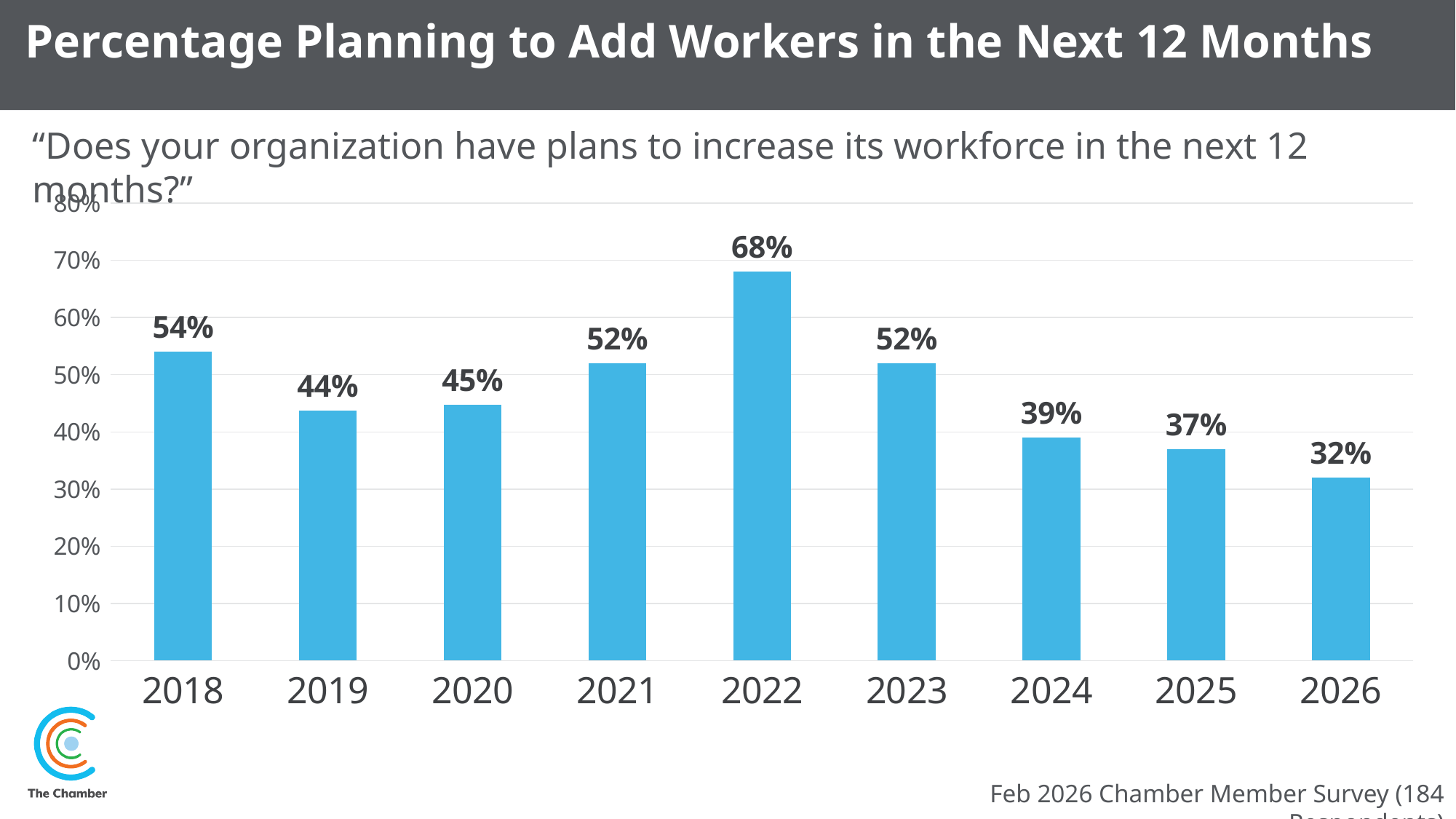
What kind of chart is shown on the slide? Bar chart What is the value shown for 2026? 32% What percentage of organizations planned to add workers in 2022? 68% How many years are shown on the x axis? 9 What is the difference between the 2018 value and the 2019 value? 10% Which year has the highest percentage planning to add workers? 2022 Do the values rise or fall from 2022 to 2026? Fall Which year has a larger value, 2020 or 2024? 2020 What is the difference between the 2022 value and the 2026 value? 36% Which year has the lowest percentage planning to add workers? 2026 Is the value for 2025 greater or less than 40%? less What is the value shown for 2019? 44%